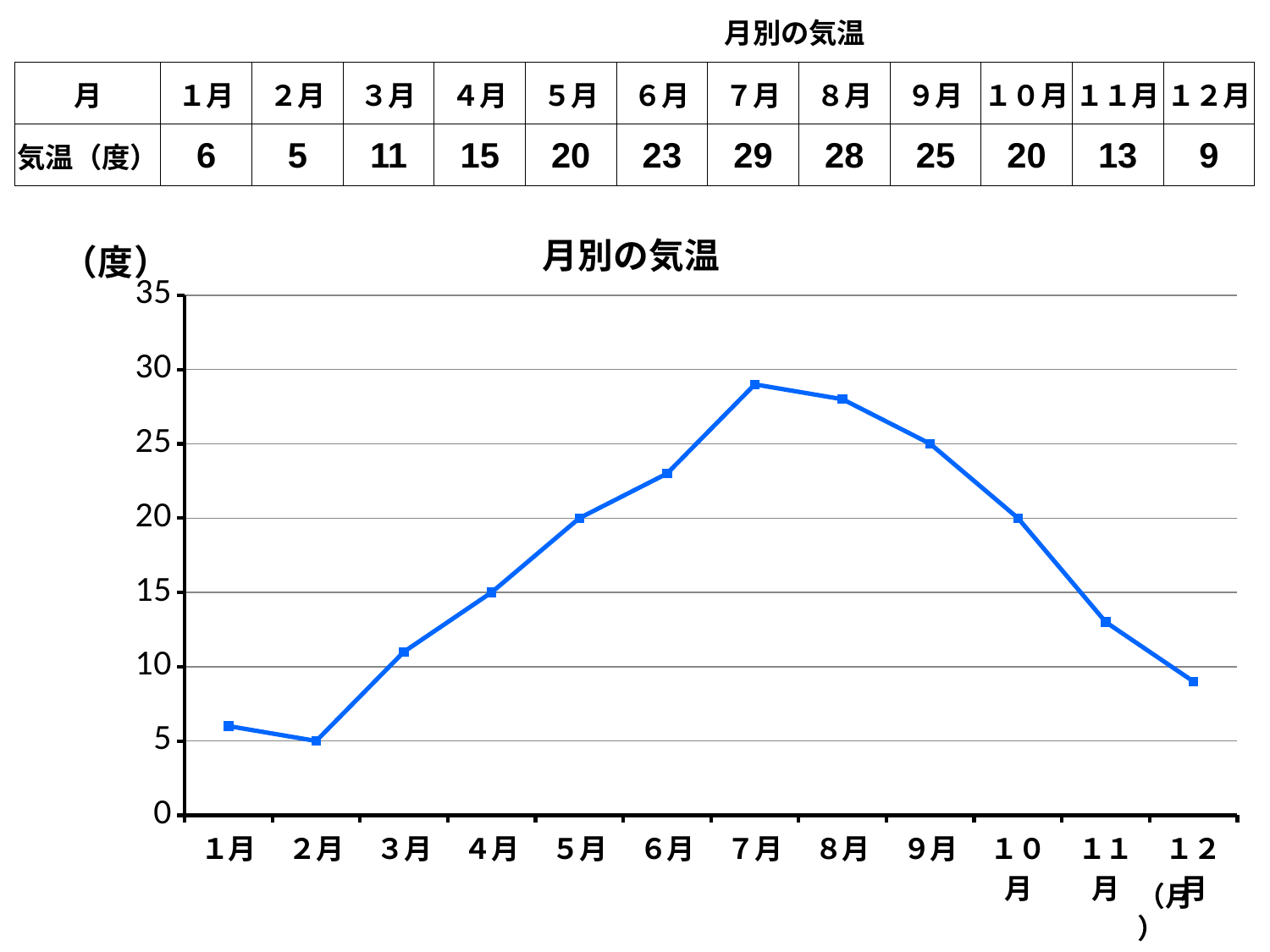
Which month has the highest temperature? 7月 What is the temperature for 7月? 29 How many months are plotted on the chart? 12 What is the temperature for 10月? 20 What is the title of the chart? 月別の気温 Which has a higher temperature, 4月 or 11月? 4月 What type of chart is shown on the slide? line chart Is the value for 9月 greater or less than 20? greater What is the temperature for 2月? 5 What is the difference in temperature between 7月 and 1月? 23 Which month has the lowest temperature? 2月 Does the temperature rise or fall from 1月 to 7月? rise